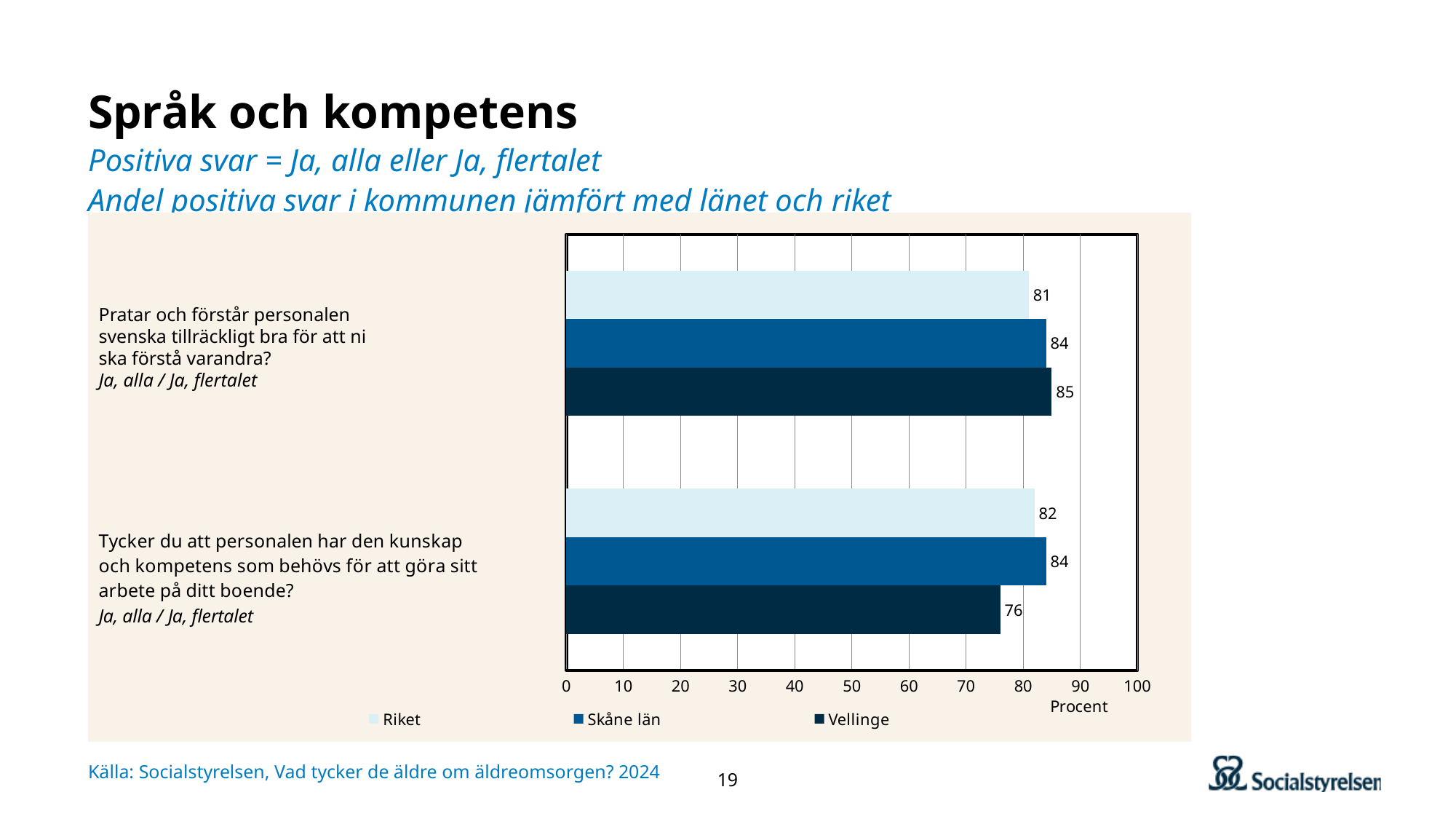
What unit is shown on the x axis of the chart? Procent What is the value for Skåne län on the question "Pratar och förstår personalen svenska tillräckligt bra för att ni ska förstå varandra?"? 84 What kind of chart is shown on the slide? Bar chart Which is larger on the question "Pratar och förstår personalen svenska tillräckligt bra för att ni ska förstå varandra?": the value for Riket or the value for Vellinge? Vellinge What is the value for Vellinge on the question "Tycker du att personalen har den kunskap och kompetens som behövs för att göra sitt arbete på ditt boende?"? 76 What is the difference between the Skåne län and Vellinge values on the question "Tycker du att personalen har den kunskap och kompetens som behövs för att göra sitt arbete på ditt boende?"? 8 Which series has the lowest value on the question "Tycker du att personalen har den kunskap och kompetens som behövs för att göra sitt arbete på ditt boende?"? Vellinge How many series does the legend list? 3 Is the value for Vellinge on the question "Tycker du att personalen har den kunskap och kompetens som behövs för att göra sitt arbete på ditt boende?" greater or less than 80? less Which series has the highest value on the question "Pratar och förstår personalen svenska tillräckligt bra för att ni ska förstå varandra?"? Vellinge What is the value for Vellinge on the question "Pratar och förstår personalen svenska tillräckligt bra för att ni ska förstå varandra?"? 85 What is the value for Riket on the question "Tycker du att personalen har den kunskap och kompetens som behövs för att göra sitt arbete på ditt boende?"? 82